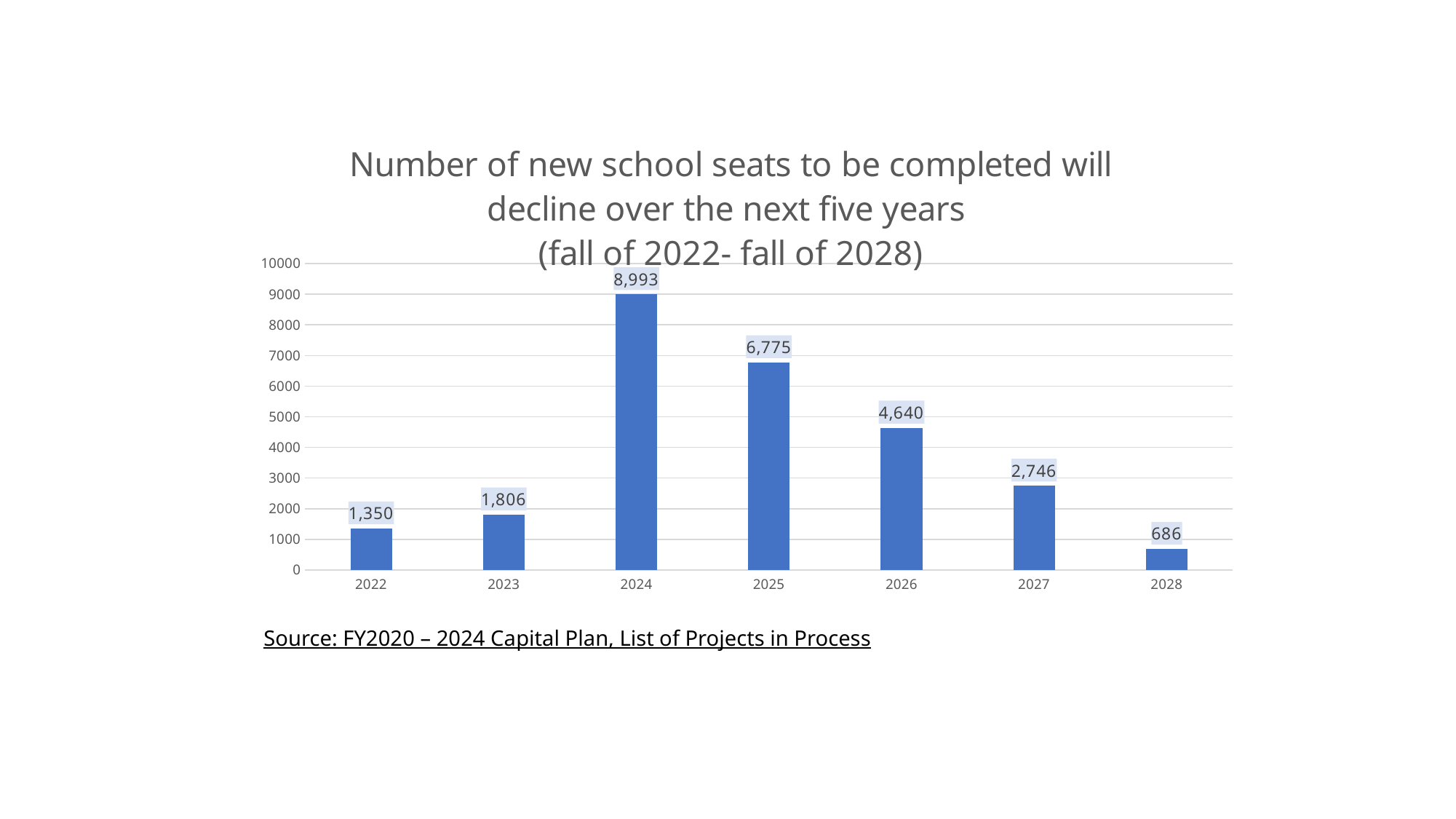
Which year has the highest number of new school seats? 2024 What is the difference between the values for 2025 and 2026? 2,135 Is the value for 2026 greater or less than 4000? greater What is the value shown for 2028? 686 Do the values rise or fall from 2024 to 2028? Fall How many years are shown on the x axis? 7 What is the number of new school seats to be completed in 2024? 8,993 What kind of chart is shown on the slide? Bar chart Which year has the lowest number of new school seats? 2028 What source is cited below the chart? FY2020 – 2024 Capital Plan, List of Projects in Process What is the value shown for 2022? 1,350 Which year has a larger value, 2023 or 2027? 2027